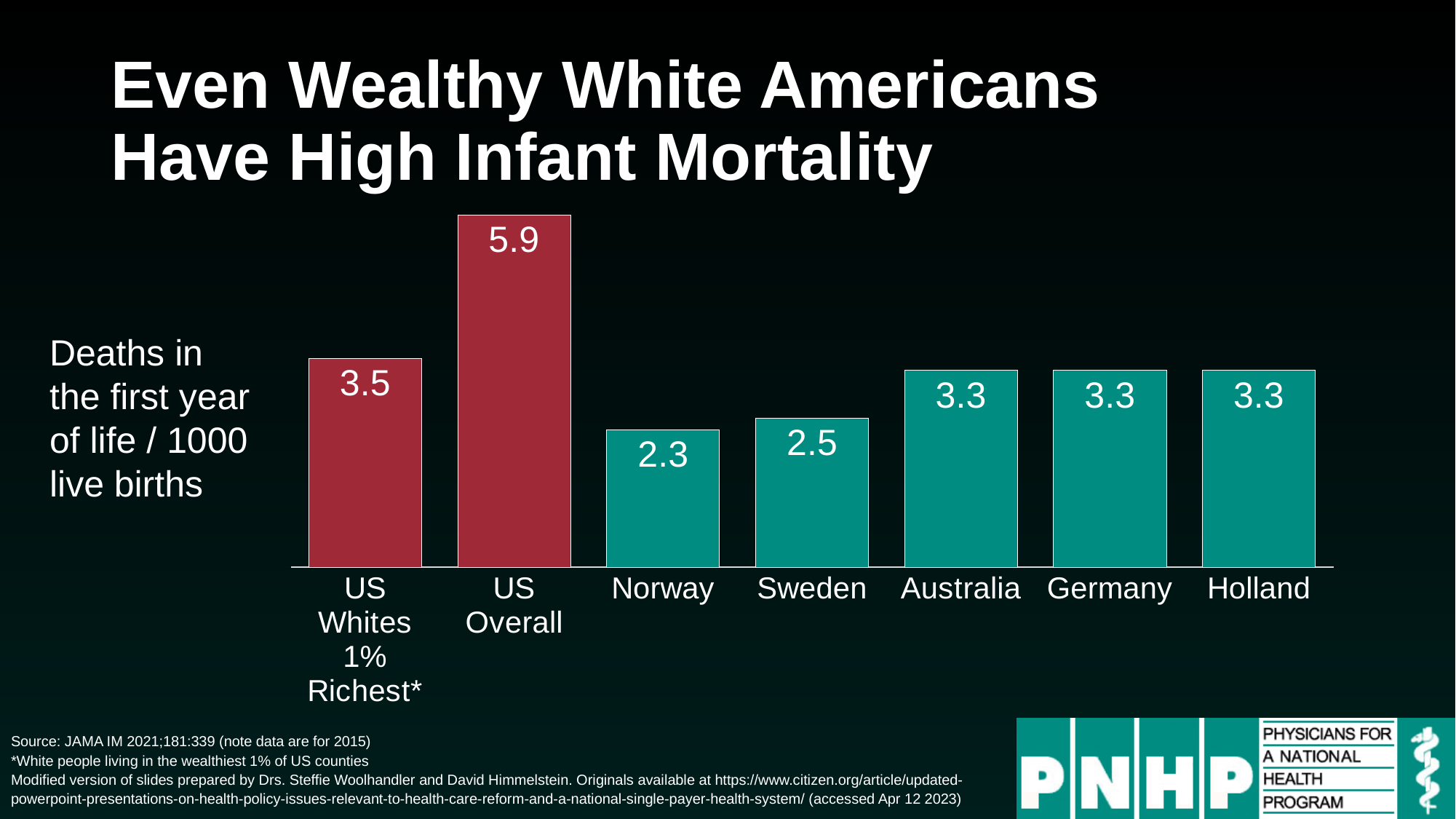
What is the difference between the value for US Whites 1% Richest* and the value for Norway? 1.2 What is the value for Norway? 2.3 Which category has the lowest value? Norway What unit does the chart measure, according to the label on the left? Deaths in the first year of life / 1000 live births What is the value for US Whites 1% Richest*? 3.5 What is the infant mortality value for US Overall? 5.9 Which is larger, the value for US Whites 1% Richest* or the value for Australia? US Whites 1% Richest* Which category has the highest value? US Overall How many categories are shown in the chart? 7 What is the value for Sweden? 2.5 What is the difference between the US Overall value and the US Whites 1% Richest* value? 2.4 What kind of chart is shown on the slide? Bar chart